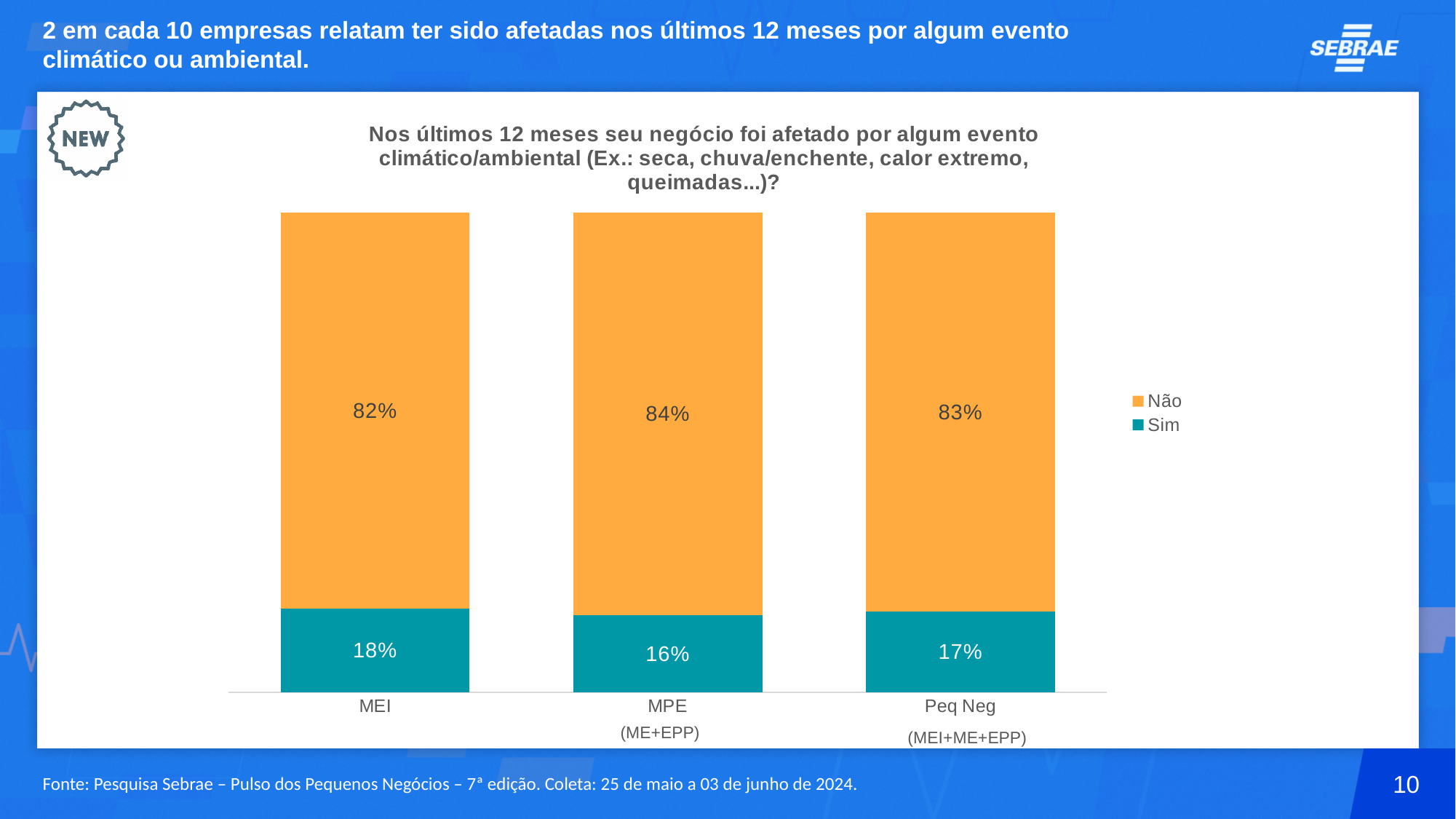
Which category has the highest "Sim" value? MEI What is the total of the stacked bar for MEI? 100% Which series is shown in orange in the legend? Não What kind of chart is shown on the slide? Stacked bar chart What is the value for "Sim" for MEI? 18% What is the value for "Não" for MPE (ME+EPP)? 84% Which category has the lowest "Sim" value? MPE (ME+EPP) What is the value for "Sim" for Peq Neg (MEI+ME+EPP)? 17% Which is larger, the "Sim" value for MEI or for Peq Neg (MEI+ME+EPP)? MEI What is the difference between the "Não" values for MPE (ME+EPP) and MEI? 2% How many series does the legend list? 2 How many categories are shown on the x axis? 3